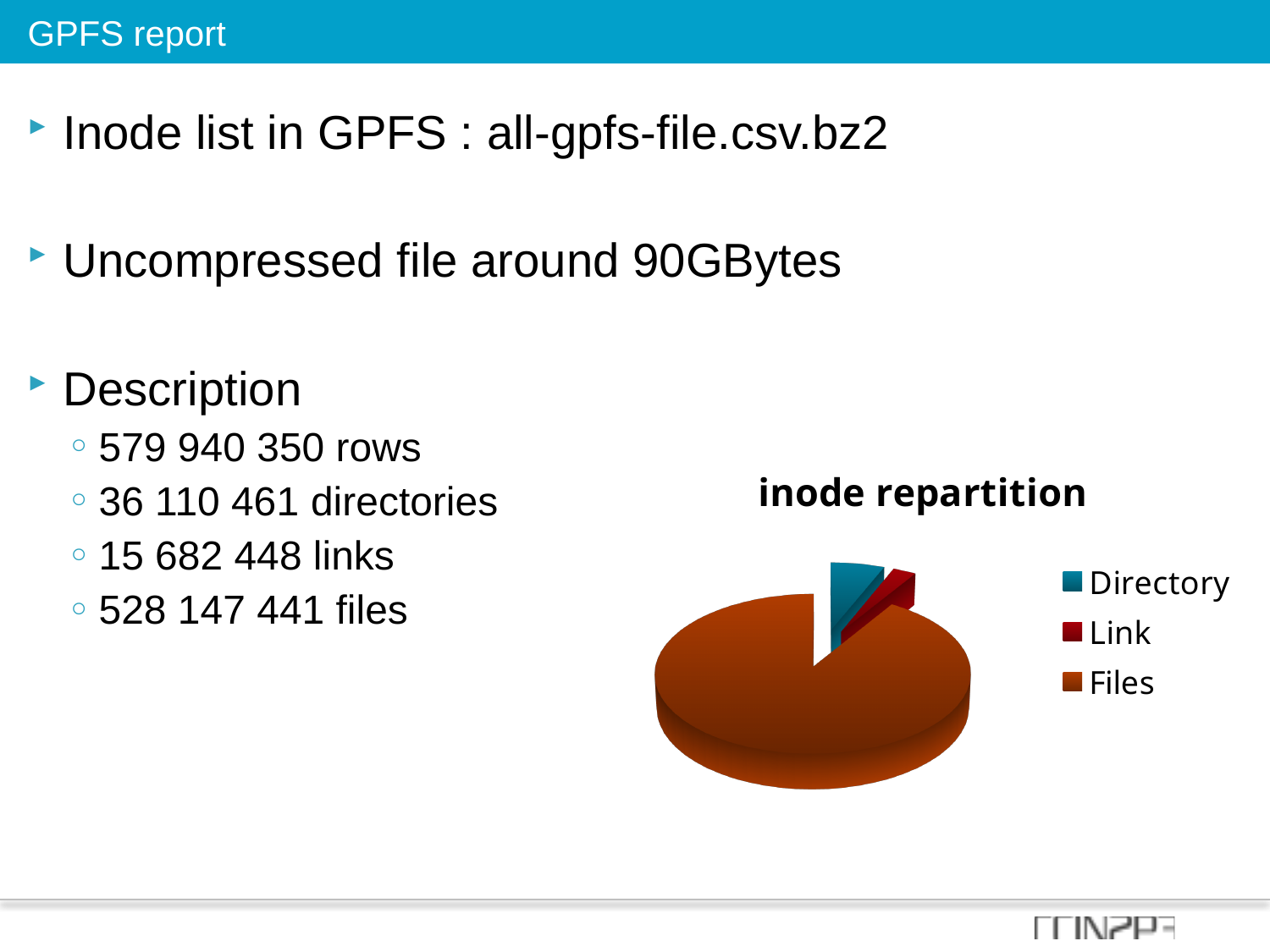
How many entries does the chart's legend list? 3 Which slice is larger, Directory or Link? Directory Which colour represents Files in the pie chart? orange-brown How many slices does the pie chart have? 3 Which slice is larger, Files or Directory? Files What kind of chart is shown on the slide? pie chart Which category has the largest slice of the pie? Files What is the title of the chart? inode repartition Which category has the smallest slice of the pie? Link